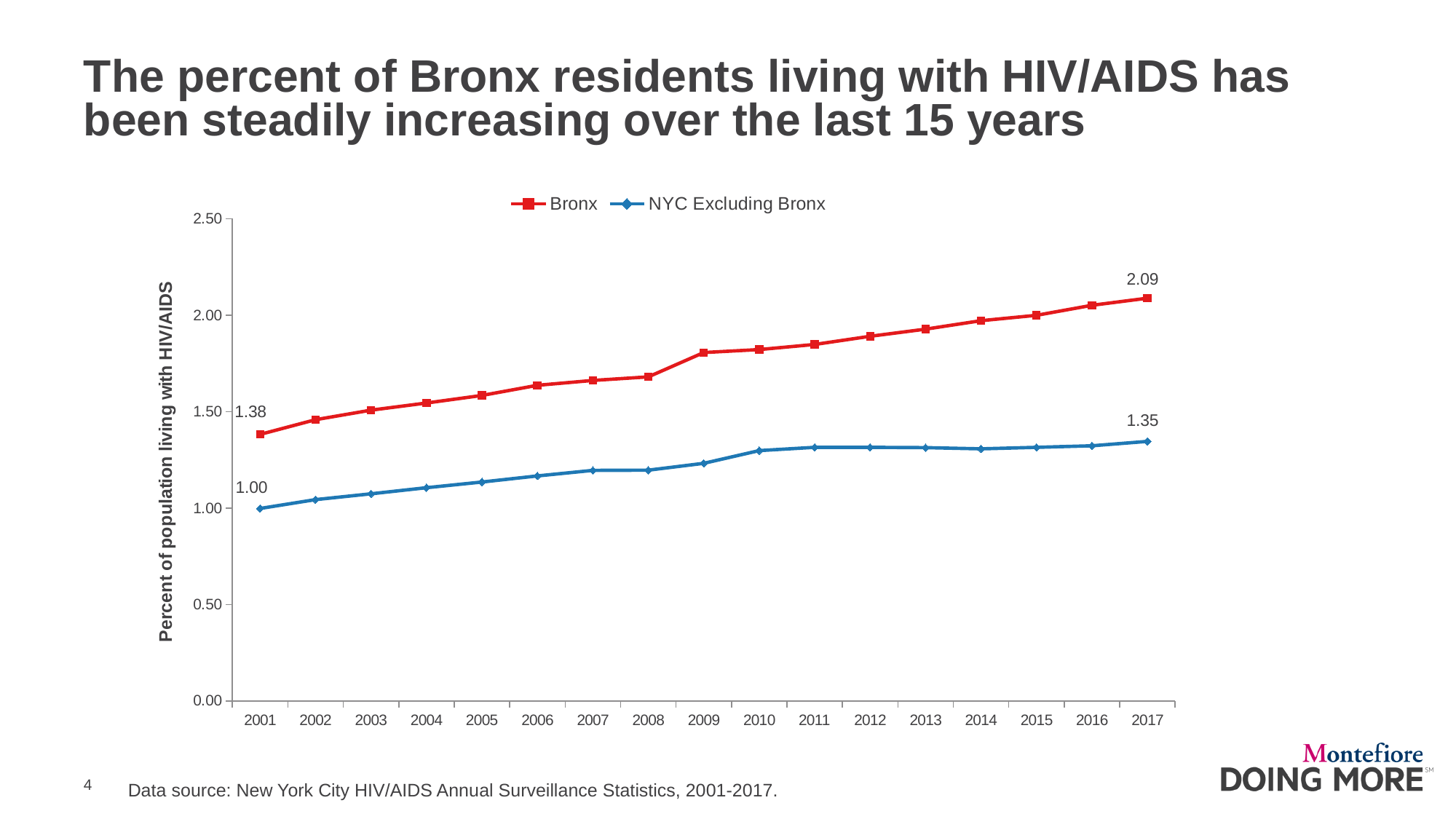
How many series does the legend list? 2 By how much did the Bronx value increase from 2001 to 2017? 0.71 What is the value for Bronx in 2017? 2.09 What is the value for NYC Excluding Bronx in 2001? 1.00 How many years are shown on the x axis? 17 What is the value for Bronx in 2001? 1.38 Does the Bronx series rise or fall from 2001 to 2017? Rise What is the value for NYC Excluding Bronx in 2017? 1.35 Is the value for Bronx in 2009 greater or less than 1.50? greater Which series has the higher value in 2010, Bronx or NYC Excluding Bronx? Bronx What type of chart is shown on the slide? Line chart What is the difference between the Bronx and NYC Excluding Bronx values in 2017? 0.74